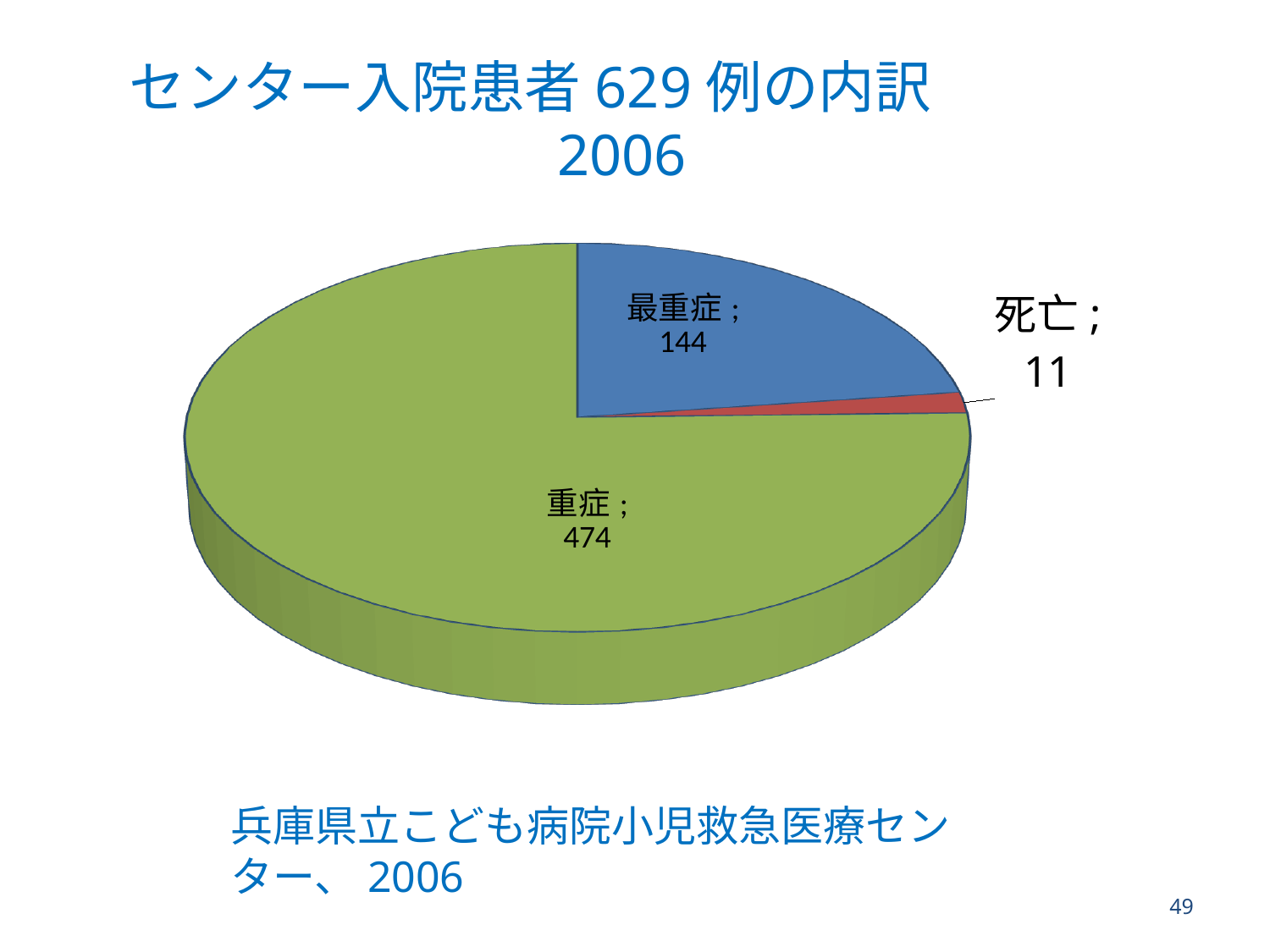
What is the value for 重症 in the pie chart? 474 What is the difference between the values for 重症 and 最重症? 330 What share of the pie does 重症 represent, to one decimal place? 75.4% What is the total of all slices in the pie chart? 629 What is the difference between the values for 最重症 and 死亡? 133 What kind of chart is shown on the slide? pie chart What is the value for 最重症 in the pie chart? 144 Which category has the largest slice of the pie chart? 重症 Which category has the smallest slice of the pie chart? 死亡 How many slices does the pie chart have? 3 Which is larger, the value for 最重症 or the value for 死亡? 最重症 What is the value for 死亡 in the pie chart? 11